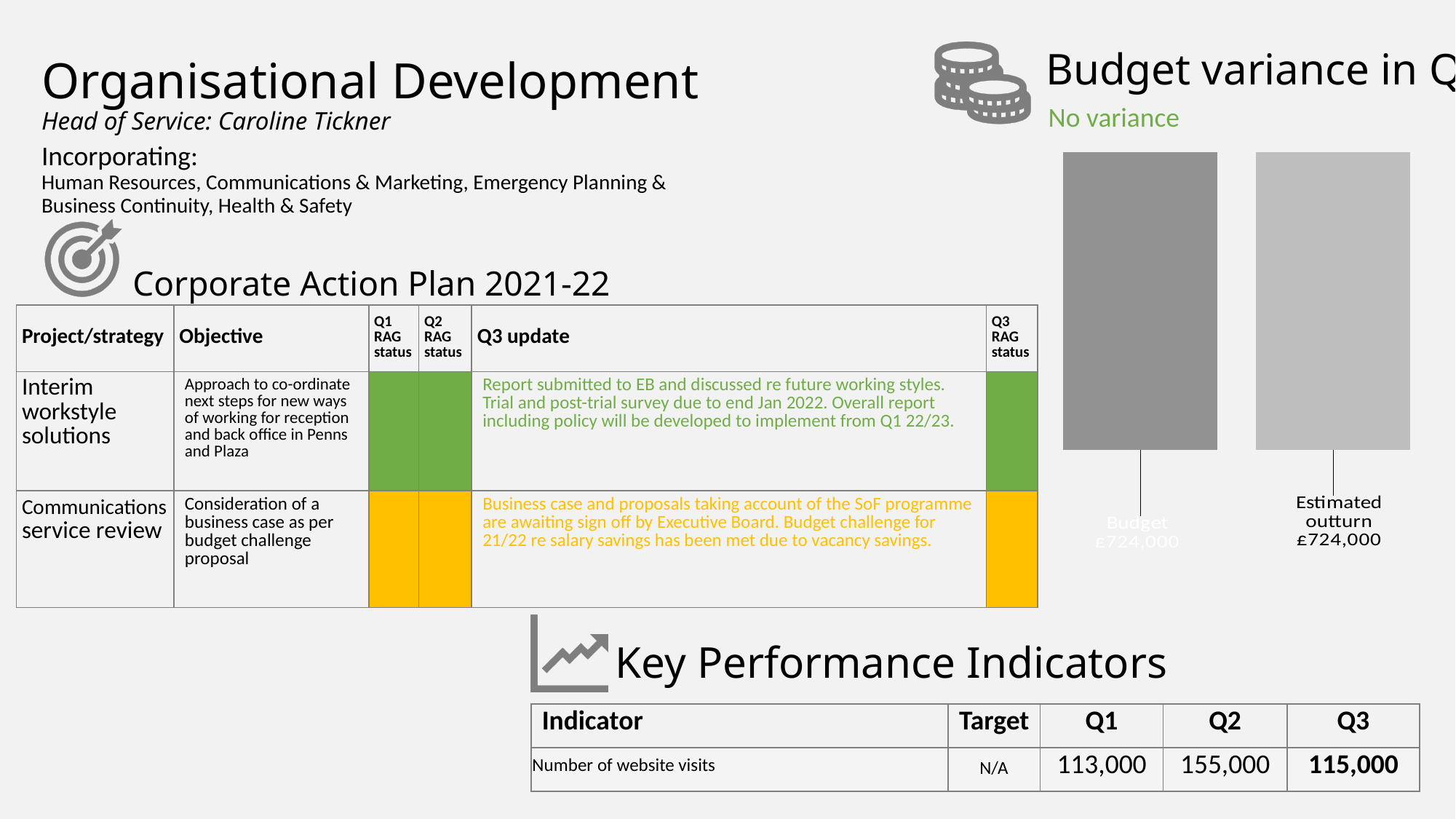
How many bars are plotted in the budget variance chart? 2 In the budget variance chart, what is the value for Budget? £724,000 What is the difference between the Budget and Estimated outturn values in the budget variance chart? £0 What are the two category labels on the budget variance chart? Budget and Estimated outturn In the budget variance chart, what is the value for Estimated outturn? £724,000 What text in green appears directly beneath the budget variance chart heading? No variance What type of chart is shown under the budget variance heading? bar chart Are the Budget and Estimated outturn bars in the budget variance chart equal in value? Yes